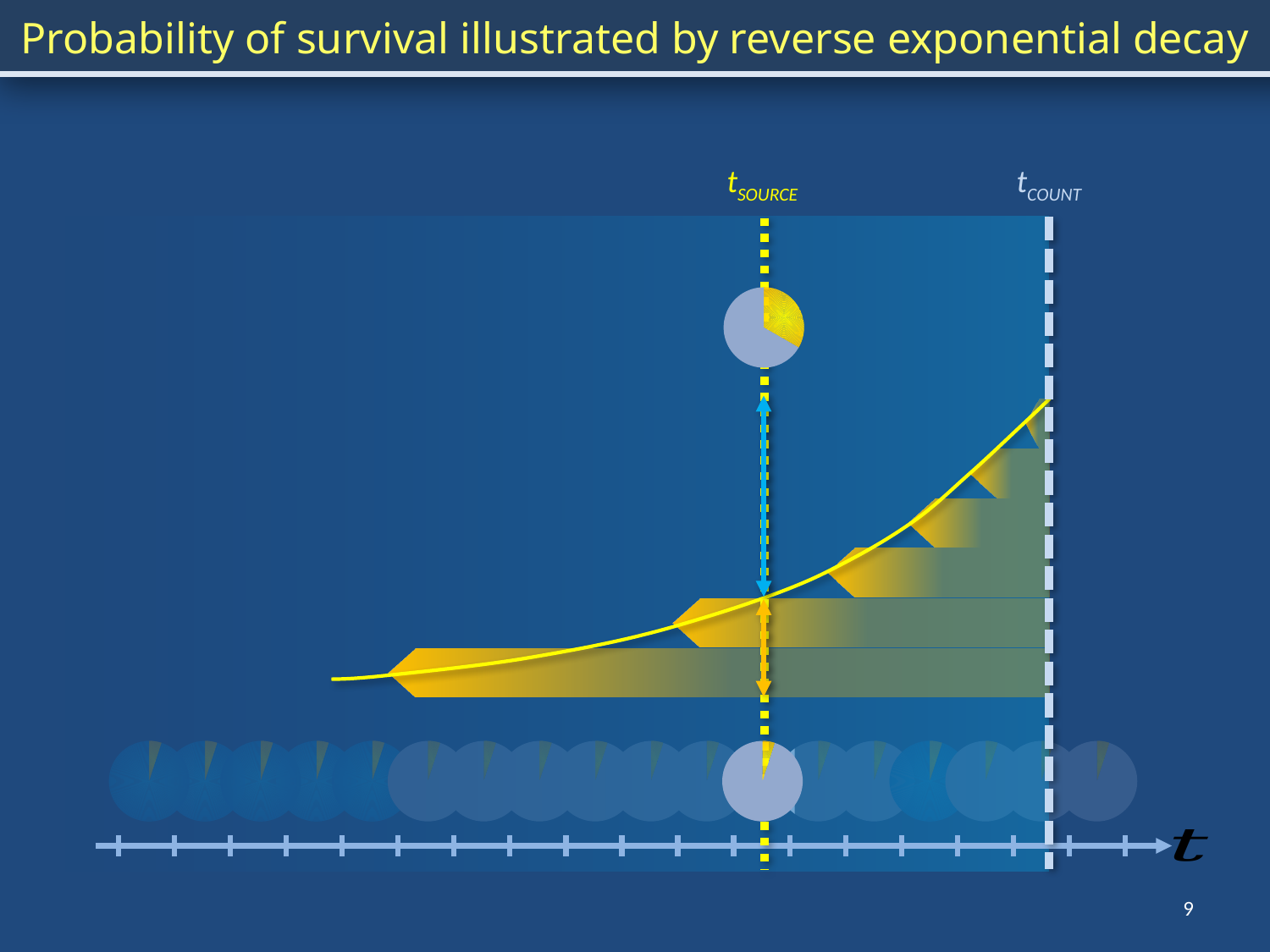
What is the title of the chart on the slide? Probability of survival illustrated by reverse exponential decay Does the yellow curve rise or fall as it moves to the right along the t axis? rises Which of the two labelled vertical dashed lines, t_SOURCE or t_COUNT, is further to the right along the t axis? t_COUNT What label is shown on the horizontal axis of the chart? t